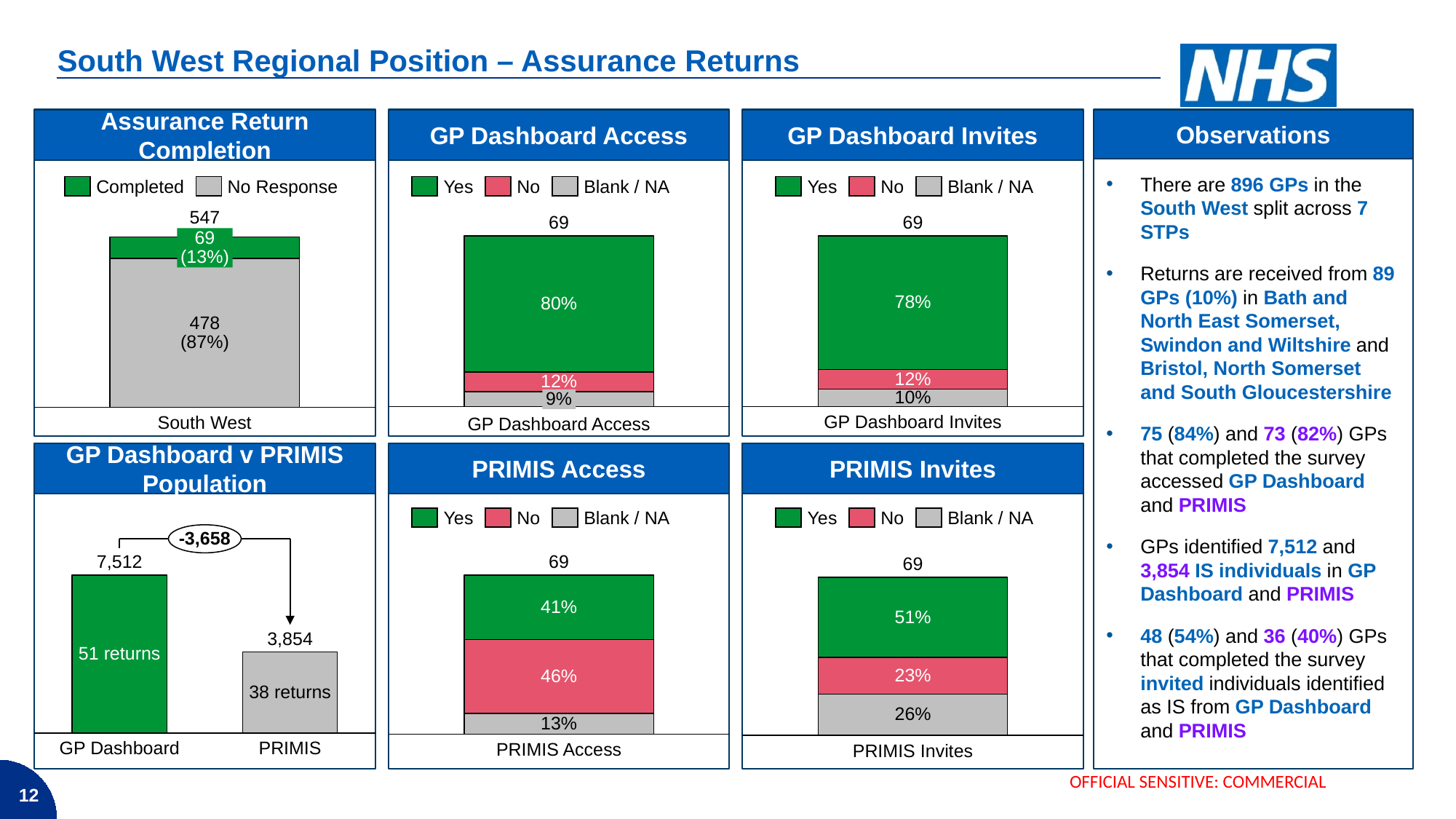
In the GP Dashboard Access chart, what is the difference between the Yes and No percentages? 68% In the PRIMIS Access chart, which is larger, Yes or No? No In the PRIMIS Invites chart, what percentage is shown for No? 23% In the GP Dashboard v PRIMIS Population chart, what is the difference between GP Dashboard and PRIMIS? 3,658 How many series does the legend of the PRIMIS Access chart list? 3 In the Assurance Return Completion chart, what is the total of the stacked bar for South West? 547 In the GP Dashboard v PRIMIS Population chart, what is the value for PRIMIS? 3,854 In the Assurance Return Completion chart, what is the value for Completed? 69 (13%) In the GP Dashboard Invites chart, which segment is the largest? Yes In the GP Dashboard Access chart, what percentage is shown for Yes? 80% In the GP Dashboard Invites chart, what percentage is shown for Blank / NA? 10% In the PRIMIS Invites chart, which segment is the smallest? No